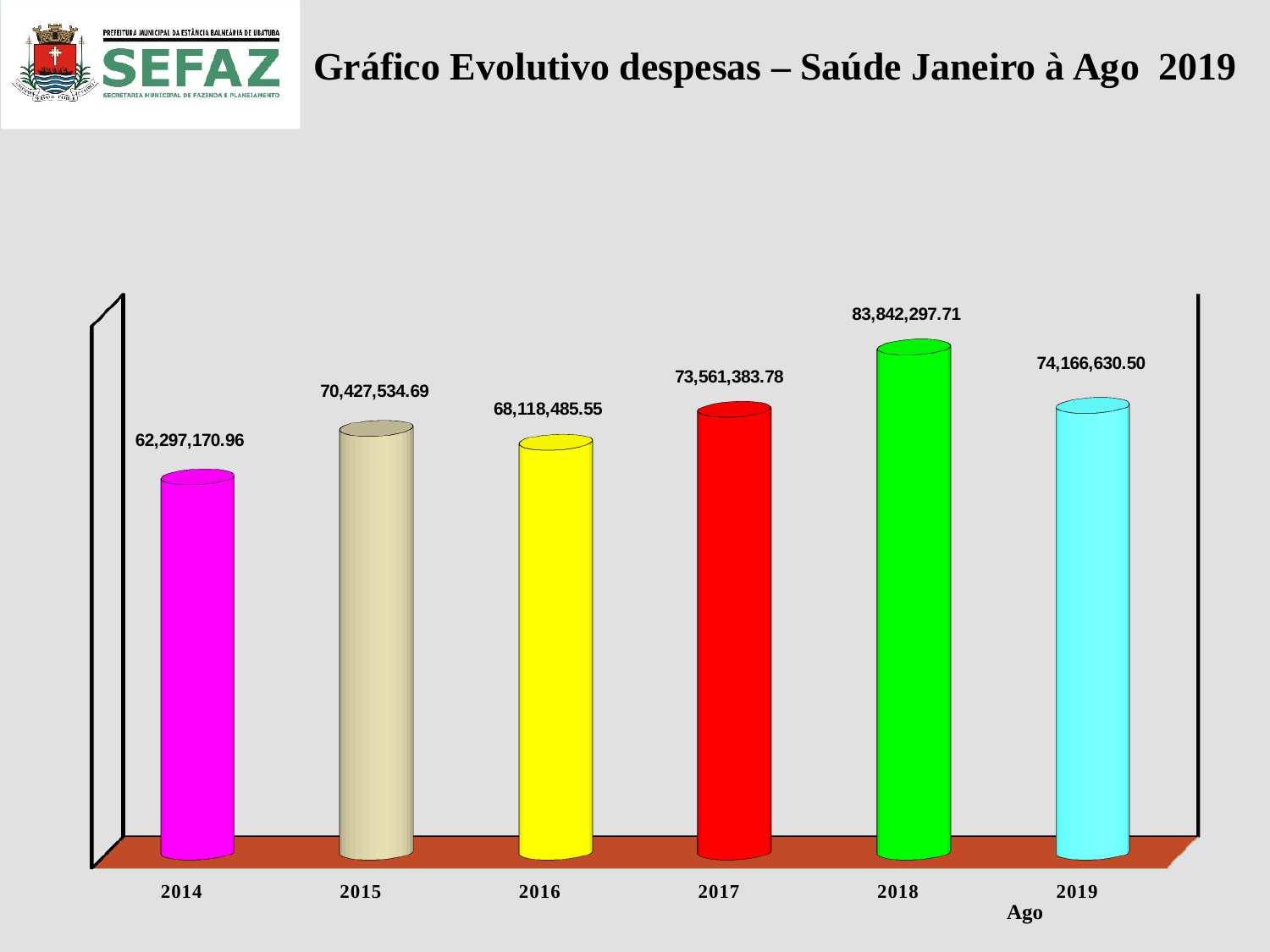
Which year has the lowest value? 2014 What is the value shown for 2019? 74,166,630.50 What kind of chart is shown on the slide? Bar chart Which is larger, the value for 2017 or the value for 2019? 2019 What is the difference between the values for 2018 and 2014? 21,545,126.75 What is the value shown for 2014? 62,297,170.96 How many years are shown on the chart? 6 What is the difference between the values for 2015 and 2016? 2,309,049.14 Do the values rise or fall from 2016 to 2018? Rise Which year has the highest value? 2018 What is the value shown for 2018? 83,842,297.71 What is the value shown for 2016? 68,118,485.55